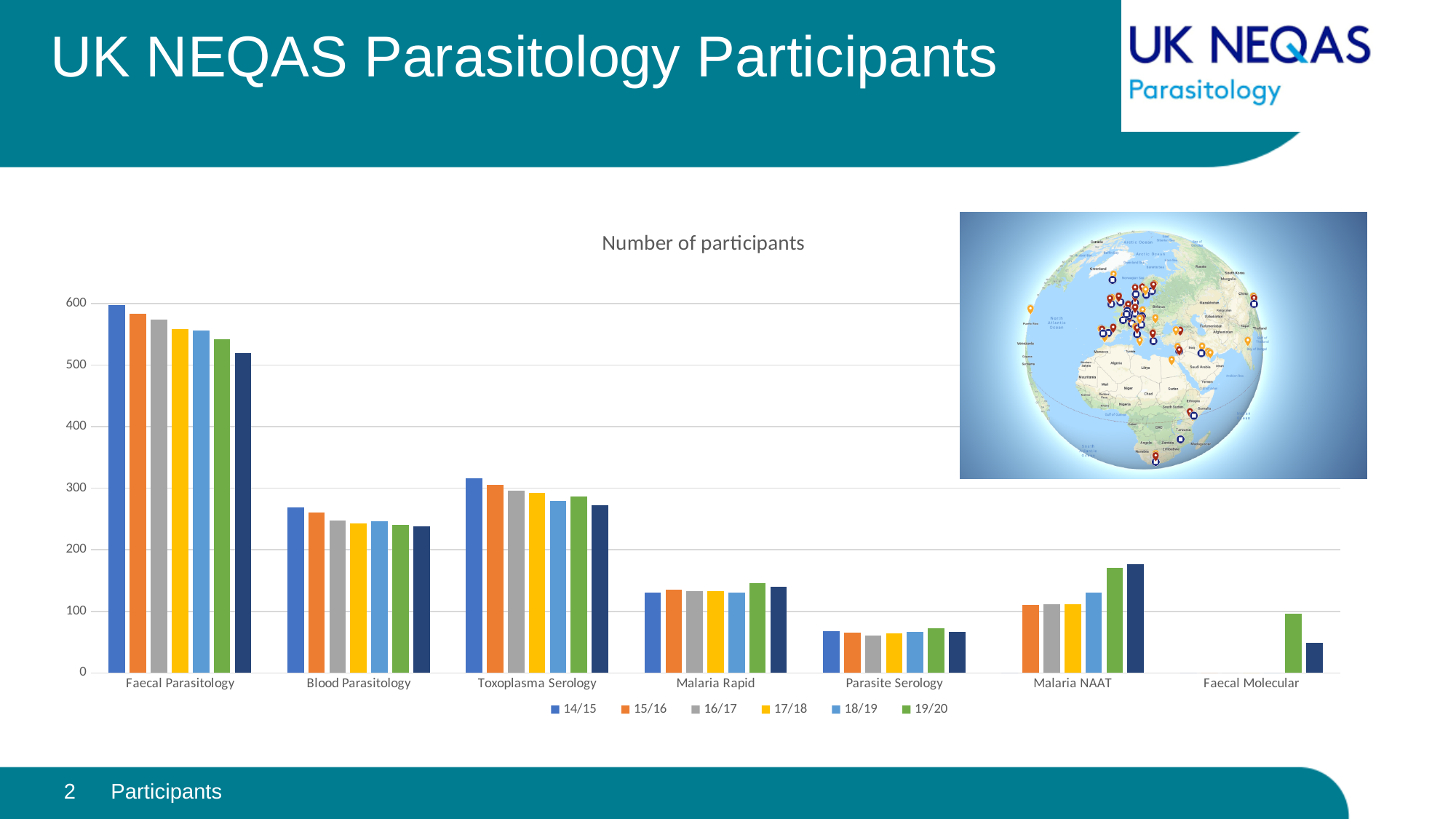
What kind of chart is shown on the slide? bar chart Which is larger, the 14/15 value for Faecal Parasitology or the 14/15 value for Blood Parasitology? Faecal Parasitology What is the title of the chart? Number of participants Is the 14/15 value for Blood Parasitology greater or less than 300? less Is the 19/20 value for Malaria Rapid greater or less than 200? less Which category has the tallest bars in the chart? Faecal Parasitology Is the 19/20 value for Malaria NAAT greater or less than 100? greater Do the Faecal Parasitology bars rise or fall from 14/15 to 19/20? fall Which is larger, the 19/20 value for Malaria NAAT or the 19/20 value for Malaria Rapid? Malaria NAAT How many categories are shown along the x axis of the chart? 7 How many series does the chart legend list? 6